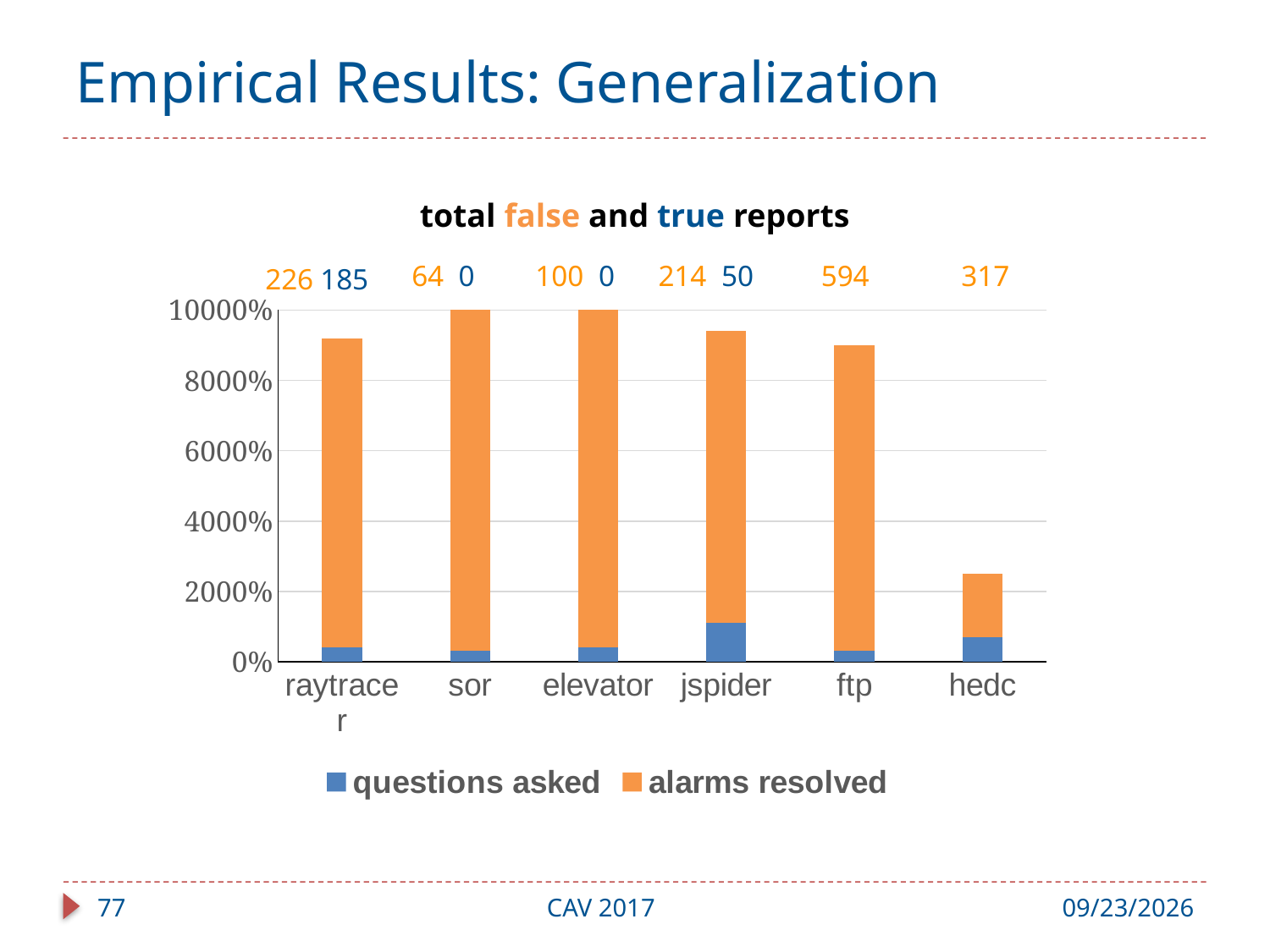
What is the title of the chart? total false and true reports What kind of chart is shown on the slide? stacked bar chart Is the total bar height for hedc greater or less than 4000%? less Which category has the lowest total bar height? hedc What are the two series named in the chart's legend? questions asked, alarms resolved Is the total bar height for raytracer greater or less than 8000%? greater How many categories are shown along the x axis of the chart? 6 Which has the larger 'questions asked' segment, jspider or sor? jspider Which has the larger total bar height, raytracer or hedc? raytracer Is the total bar height for ftp greater or less than 8000%? greater How many series does the chart's legend list? 2 What false-report count is printed in orange above the ftp bar? 594